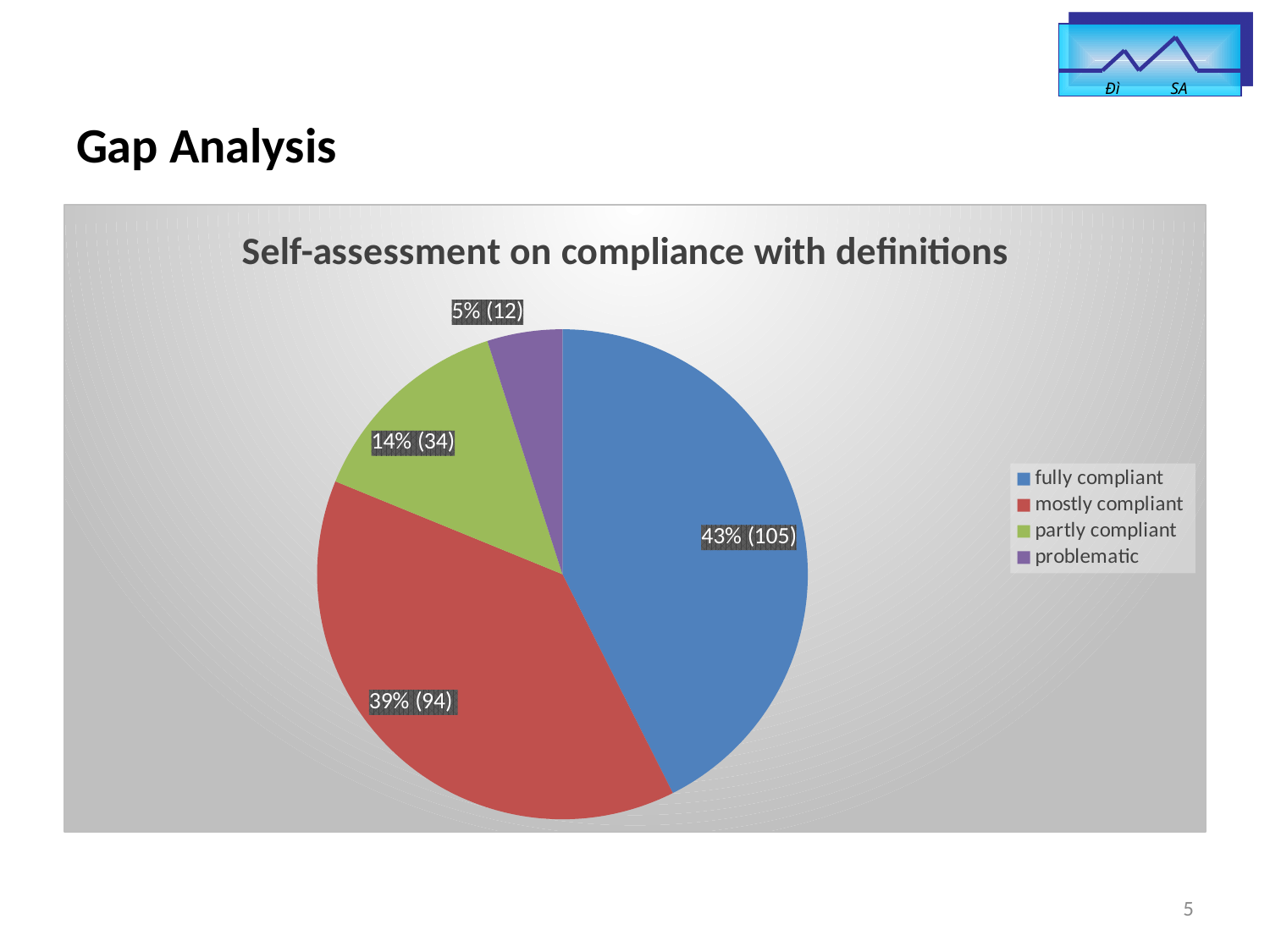
How many categories does the legend list? 4 What count is shown for 'mostly compliant'? 94 Which category has the smallest slice? problematic What is the total count across all four categories? 245 What is the title of the chart? Self-assessment on compliance with definitions Which is larger, the slice for 'partly compliant' or the slice for 'problematic'? partly compliant Which category has the largest slice? fully compliant What kind of chart is shown on the slide? pie chart What count is shown for 'problematic'? 12 What share of the pie is labelled for 'fully compliant'? 43% What is the difference in count between 'fully compliant' and 'mostly compliant'? 11 What share of the pie is labelled for 'partly compliant'? 14%